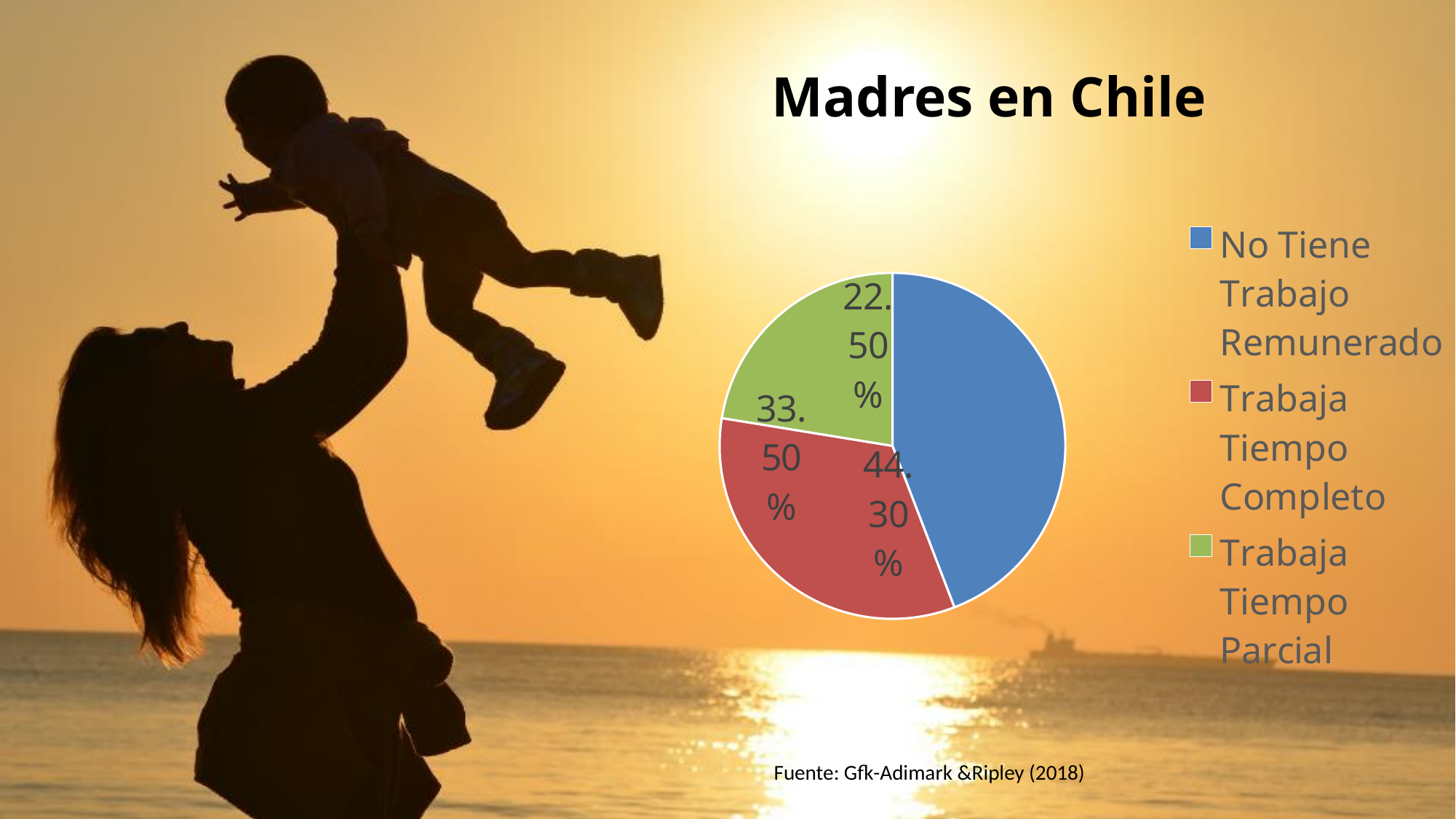
What percentage of the pie is labelled for Trabaja Tiempo Completo? 33.50% How many categories does the legend list? 3 What percentage of the pie is labelled for Trabaja Tiempo Parcial? 22.50% Which is larger: the slice for Trabaja Tiempo Completo or the slice for Trabaja Tiempo Parcial? Trabaja Tiempo Completo What is the difference in percentage points between Trabaja Tiempo Completo and Trabaja Tiempo Parcial? 11.00 What colour is the slice for Trabaja Tiempo Completo? red What is the difference in percentage points between No Tiene Trabajo Remunerado and Trabaja Tiempo Parcial? 21.80 What percentage of the pie is labelled for No Tiene Trabajo Remunerado? 44.30% What kind of chart is shown on the slide? pie chart Which category has the smallest slice of the pie? Trabaja Tiempo Parcial Which category has the largest slice of the pie? No Tiene Trabajo Remunerado What is the title of the chart? Madres en Chile